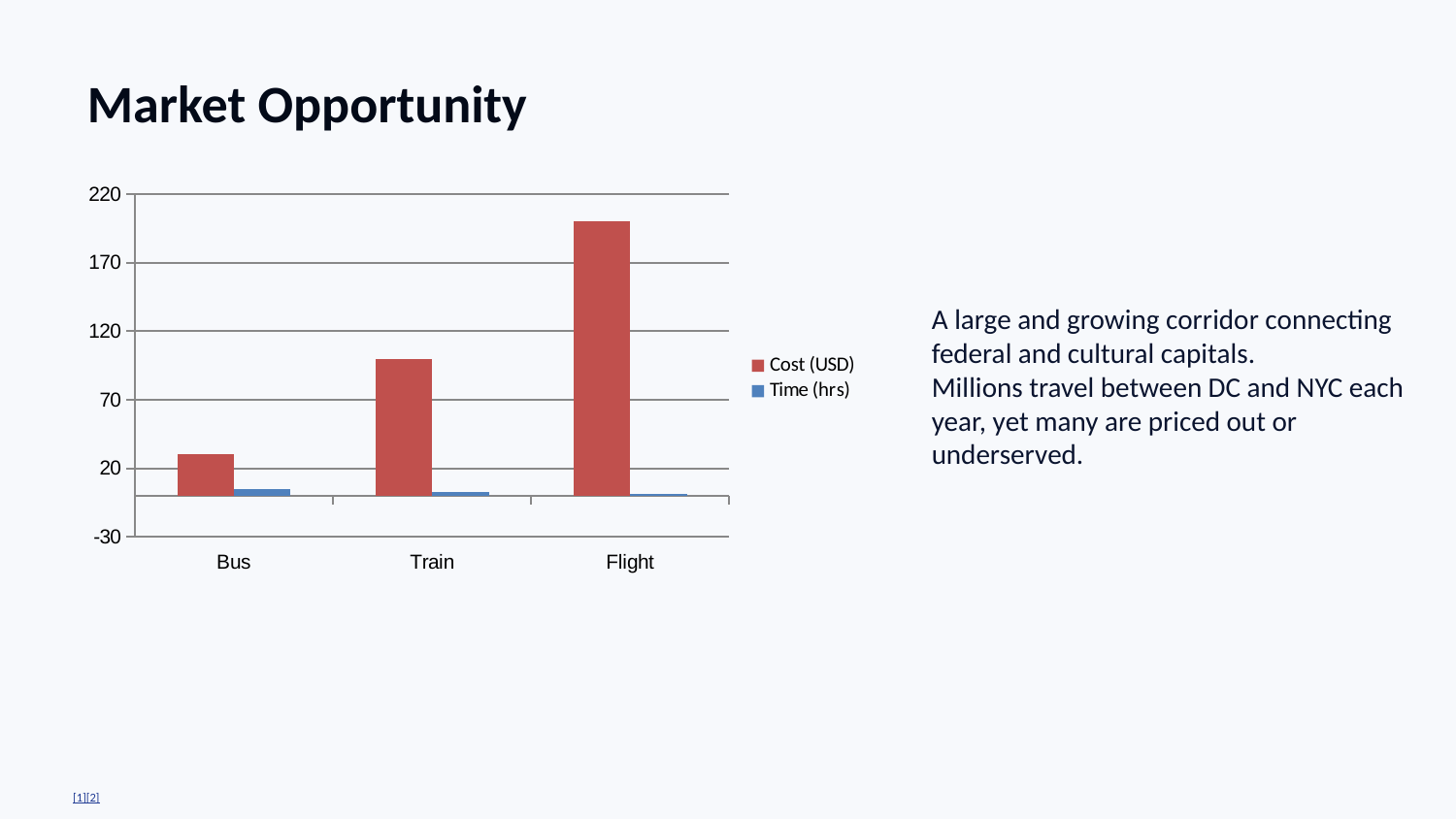
Does the Cost (USD) series rise or fall from Bus to Flight along the x axis? rise How many series does the chart's legend list? 2 Which category has the lowest Cost (USD) value? Bus Which is larger, the Time (hrs) value for Bus or for Flight? Bus What kind of chart is shown on the slide? bar chart What colour are the Cost (USD) bars in the chart? red Which is larger, the Cost (USD) value for Train or for Bus? Train How many categories are shown on the x axis of the chart? 3 Is the Cost (USD) value for Bus greater or less than 70? less Which category has the highest Cost (USD) value? Flight Is the Cost (USD) value for Train greater or less than 70? greater Is the Cost (USD) value for Flight greater or less than 170? greater